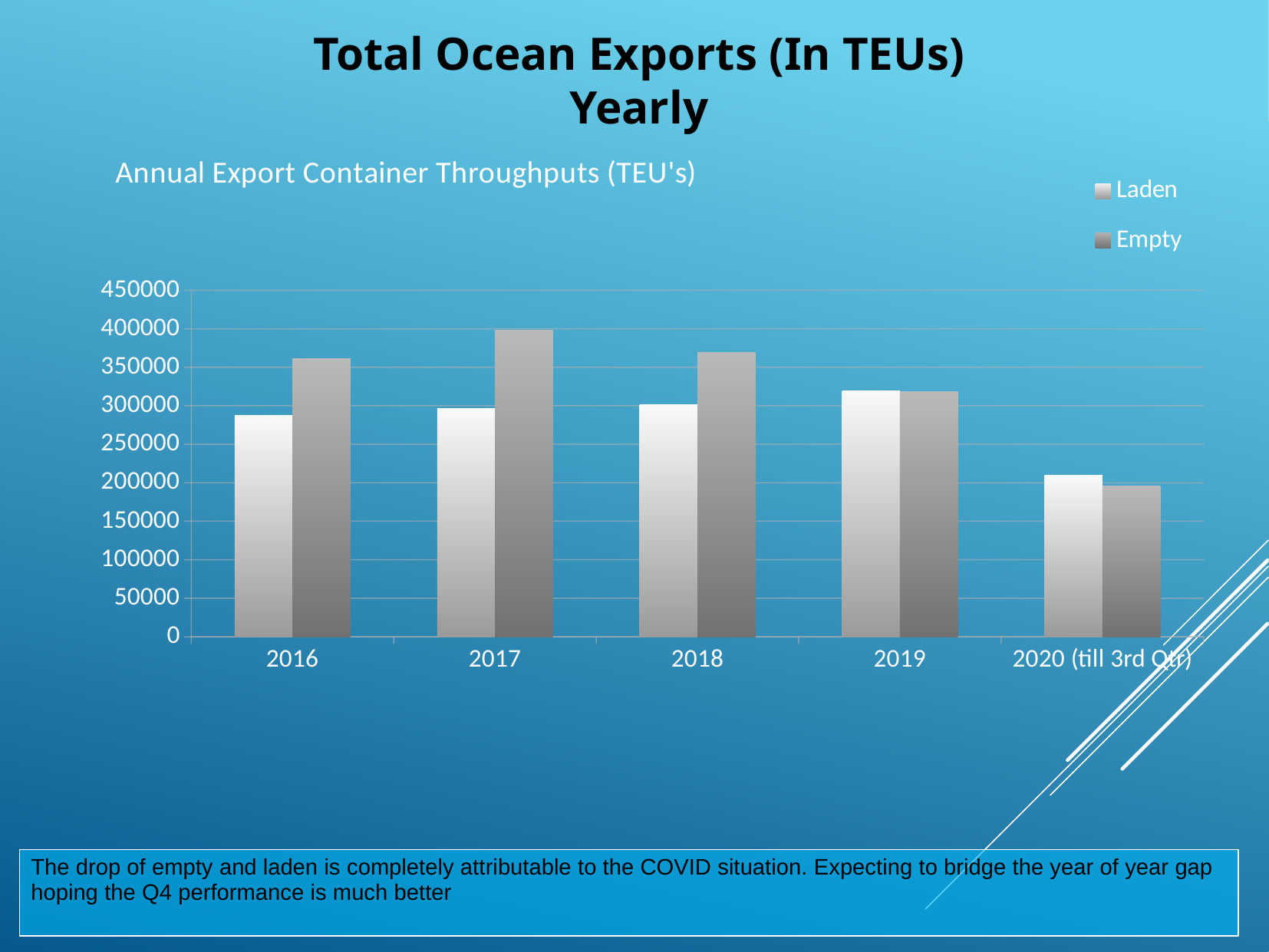
Is the Empty value for 2017 greater or less than 350000? greater What kind of chart is shown on the slide? bar chart How many series does the legend list? 2 Is the Laden value for 2016 greater or less than 300000? less Which year has the highest Empty value? 2017 Does the Laden value rise or fall from 2016 to 2019? rise What is the title shown inside the chart area? Annual Export Container Throughputs (TEU's) How many year categories are shown on the x axis? 5 Is the Empty value for 2018 greater or less than 350000? greater In 2017, which is larger, Laden or Empty? Empty Which year has the lowest Laden value? 2020 (till 3rd Qtr) Which year has the highest Laden value? 2019